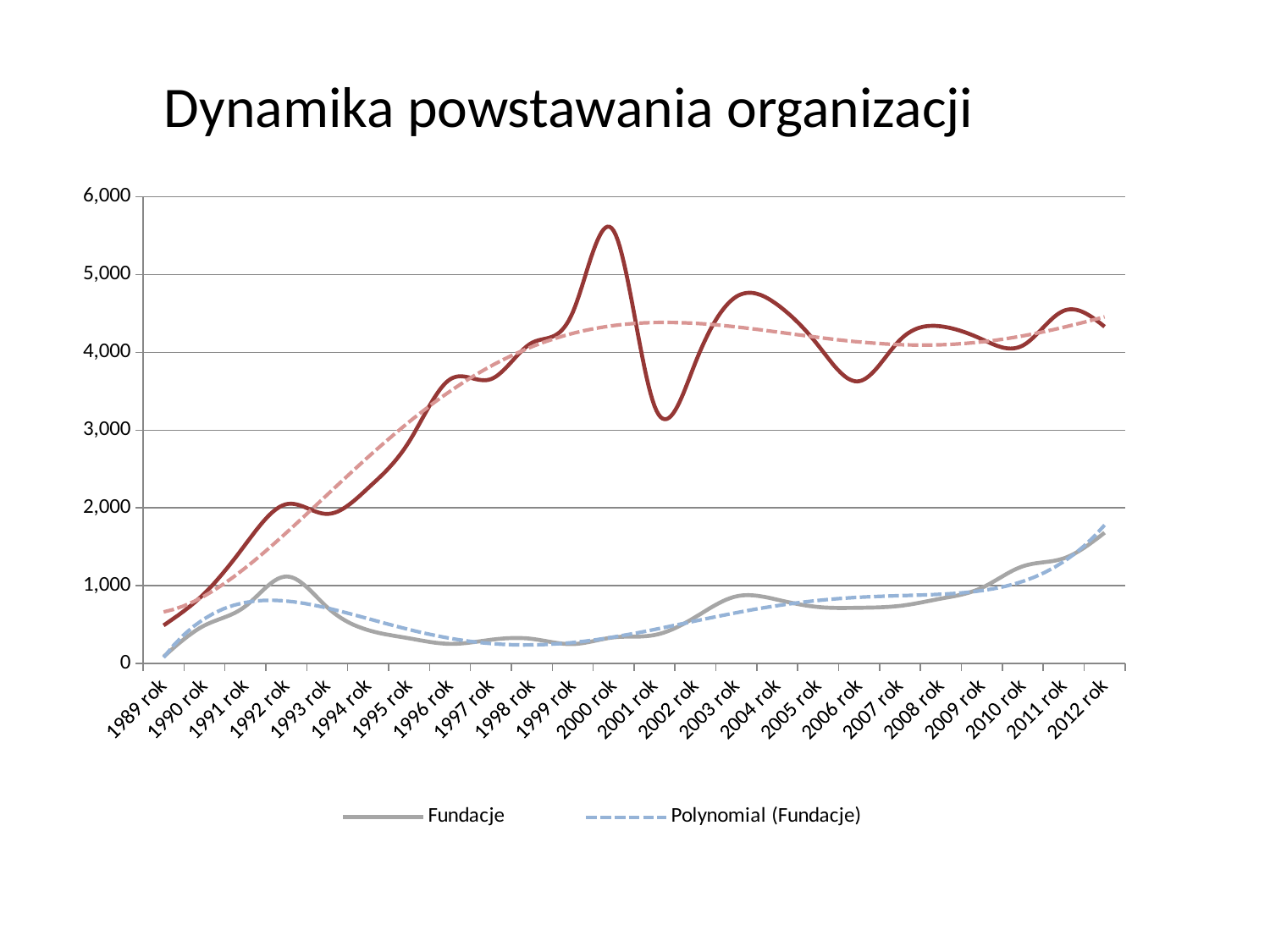
Is the value for Fundacje in 2012 rok greater or less than 1,000? greater How many series does the legend list? 2 What are the two entries in the chart legend? Fundacje and Polynomial (Fundacje) In which year does the Fundacje series have its lowest value? 1989 rok How many years are shown on the x axis? 24 Is the value for Fundacje in 1996 rok greater or less than 1,000? less In which year does the solid dark red line reach its highest peak? 2000 rok In which year does the Fundacje series reach its highest value? 2012 rok What is the title of the chart? Dynamika powstawania organizacji What kind of chart is shown on the slide? line chart Which is larger for Fundacje: the value in 2012 rok or the value in 1989 rok? 2012 rok Does the Fundacje series rise or fall between 2006 rok and 2012 rok? rise